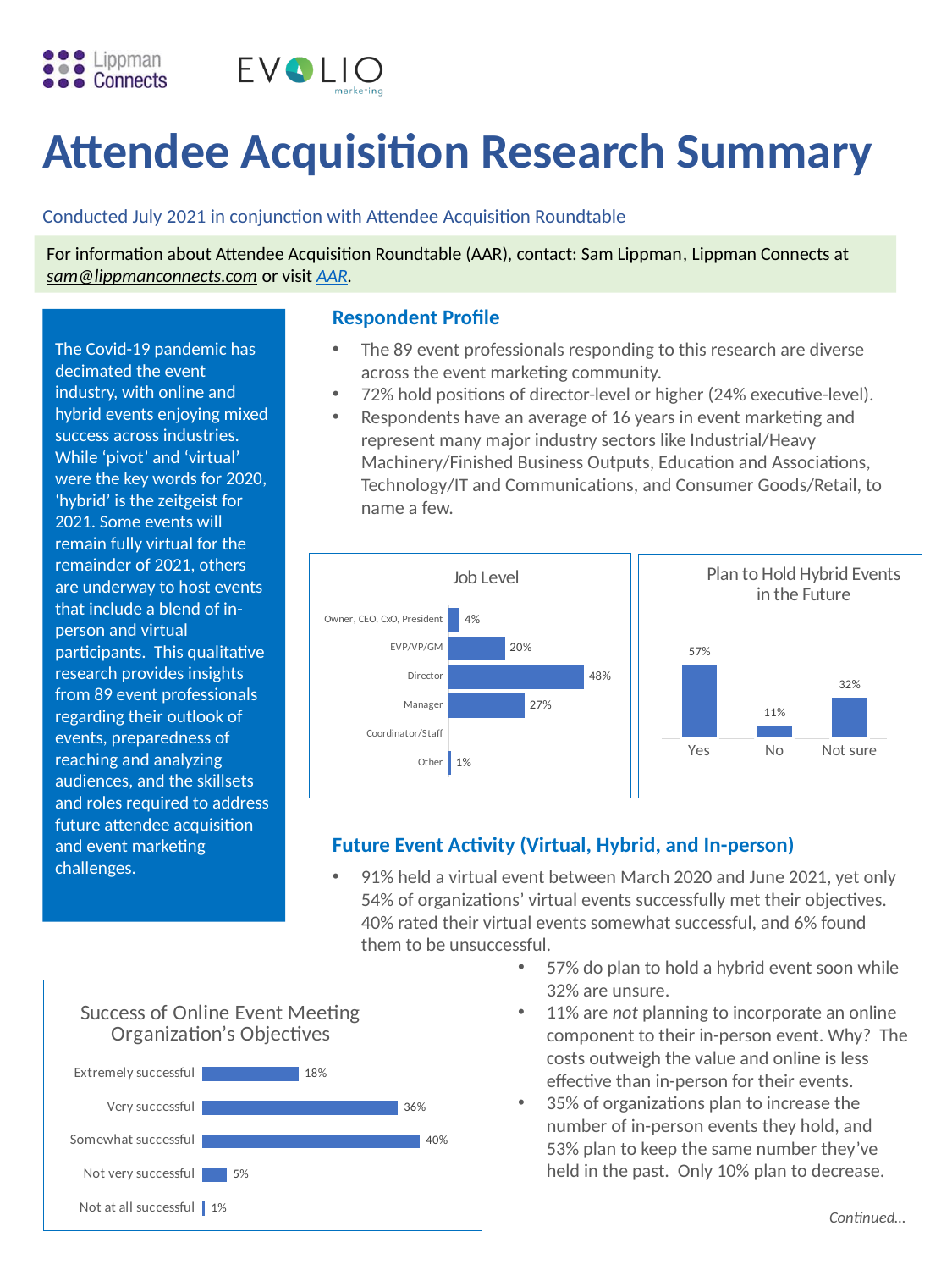
In the Job Level chart, which job level has the highest percentage? Director In the Plan to Hold Hybrid Events in the Future chart, what is the difference between Yes and Not sure? 25% In the Success of Online Event Meeting Organization's Objectives chart, what percentage rated their events Very successful? 36% In the Plan to Hold Hybrid Events in the Future chart, what percentage answered Yes? 57% In the Plan to Hold Hybrid Events in the Future chart, which response has the lowest percentage? No In the Job Level chart, what percentage of respondents are at the Director level? 48% In the Job Level chart, how many job level categories are listed? 6 In the Success of Online Event Meeting Organization's Objectives chart, which is larger: Extremely successful or Not very successful? Extremely successful What type of chart is the Job Level chart? Bar chart In the Job Level chart, what is the difference between the Manager and EVP/VP/GM percentages? 7% In the Success of Online Event Meeting Organization's Objectives chart, how many categories are shown? 5 In the Success of Online Event Meeting Organization's Objectives chart, which category has the highest percentage? Somewhat successful